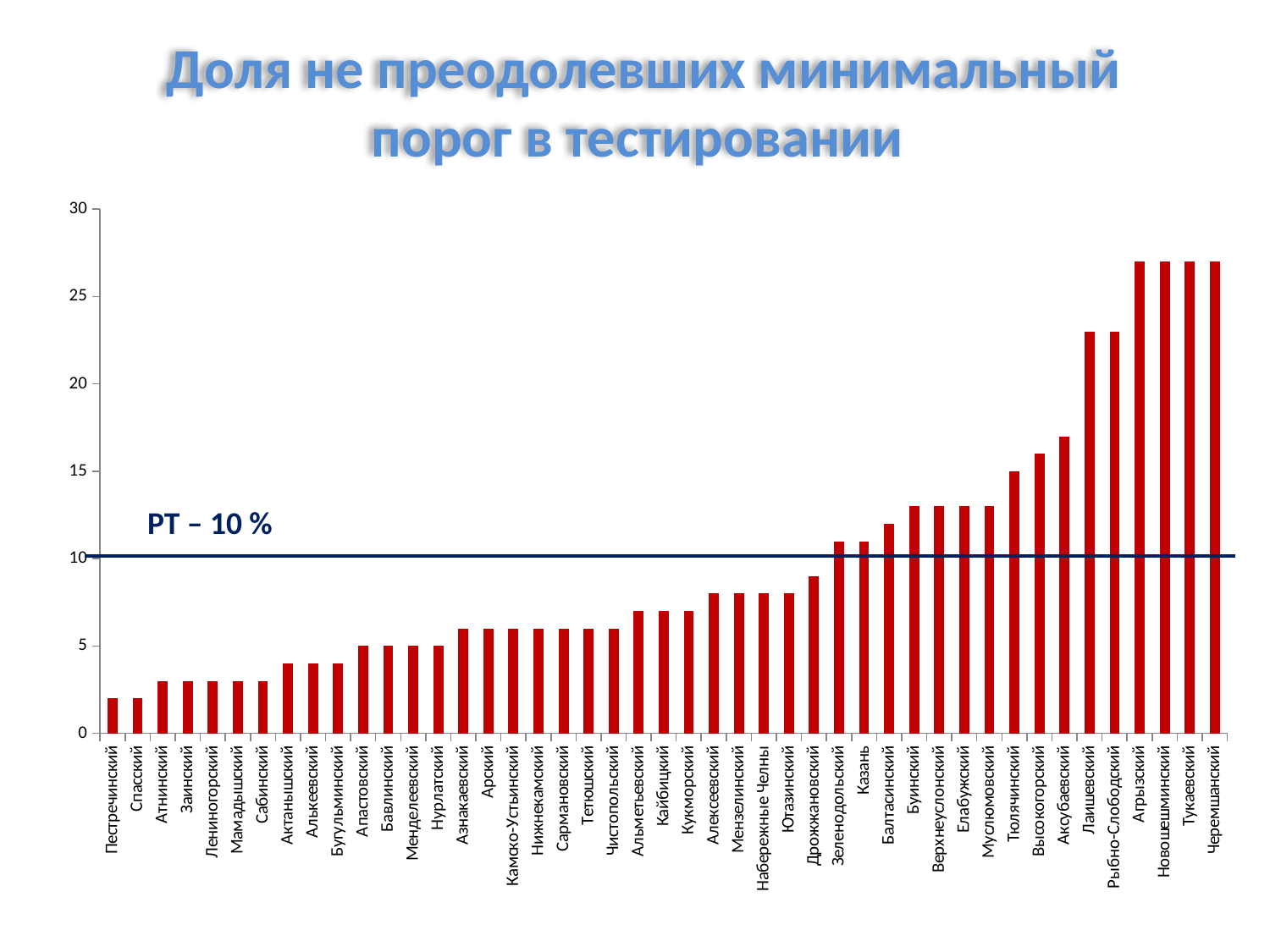
How many categories (bars) are plotted on the chart? 45 Which has the larger value, Агрызский or Азнакаевский? Агрызский Is the value for Казань greater or less than 10? greater Is the value for Черемшанский greater or less than 25? greater What label is written next to the horizontal reference line on the chart? РТ – 10 % What is the title of the chart? Доля не преодолевших минимальный порог в тестировании Is the value for Пестречинский greater or less than 5? less Do the bar values generally rise or fall from left to right along the x axis? rise Which has the larger value, Спасский or Высокогорский? Высокогорский What kind of chart is shown on the slide? bar chart